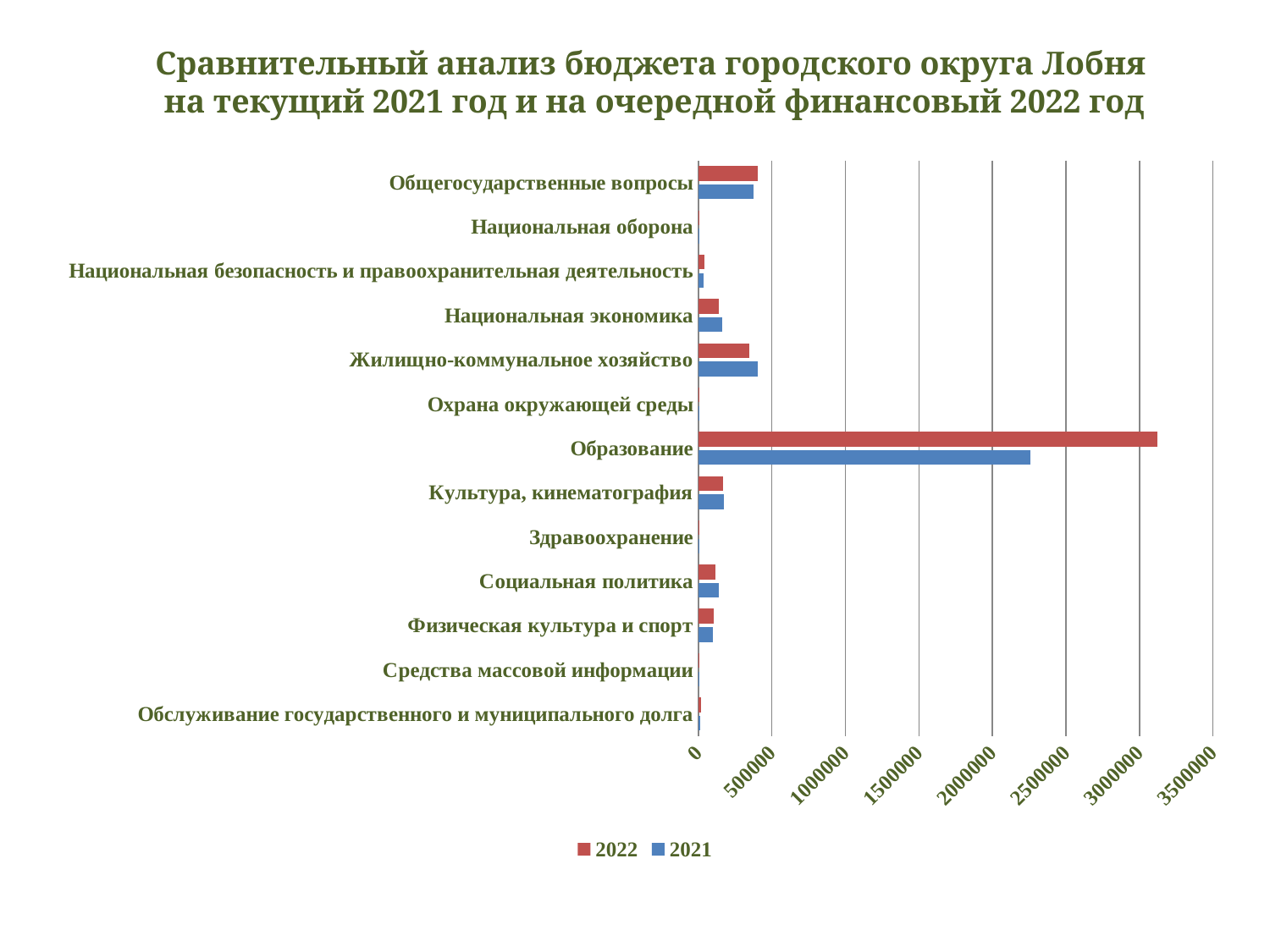
Is the 2021 value for Образование greater or less than 2000000? greater How many series does the legend list? 2 Which series is shown in red in the legend? 2022 How many categories are shown on the vertical axis of the chart? 13 Which series is shown in blue in the legend? 2021 Is the 2022 value for Образование greater or less than 3000000? greater Is the 2021 value for Образование greater or less than 2500000? less What kind of chart is shown on the slide? bar chart Which category has the highest value for the 2021 series? Образование Which category has the highest value for the 2022 series? Образование For Образование, which series has the larger value, 2022 or 2021? 2022